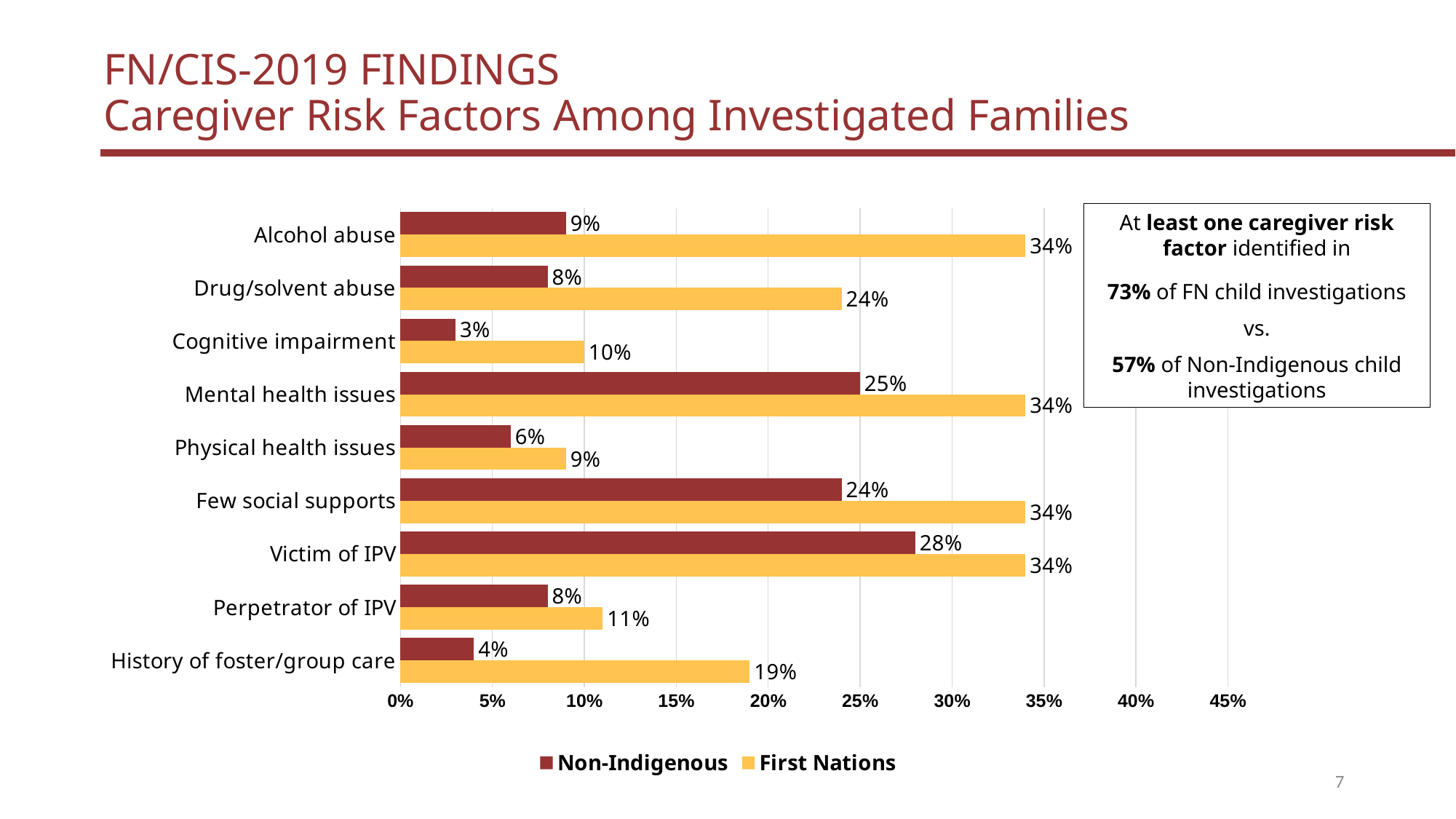
What kind of chart is shown on the slide? Bar chart What is the difference between the First Nations and Non-Indigenous values for History of foster/group care? 15% How many categories are shown on the chart? 9 Which category has the lowest First Nations value? Physical health issues Which category has the lowest Non-Indigenous value? Cognitive impairment How many series does the legend list? 2 What is the difference between the First Nations and Non-Indigenous values for Alcohol abuse? 25% Which is larger: the Non-Indigenous value for Mental health issues or the Non-Indigenous value for Few social supports? Mental health issues Which category has the highest Non-Indigenous value? Victim of IPV What is the First Nations value for History of foster/group care? 19% What is the First Nations value for Drug/solvent abuse? 24% What is the Non-Indigenous value for Victim of IPV? 28%